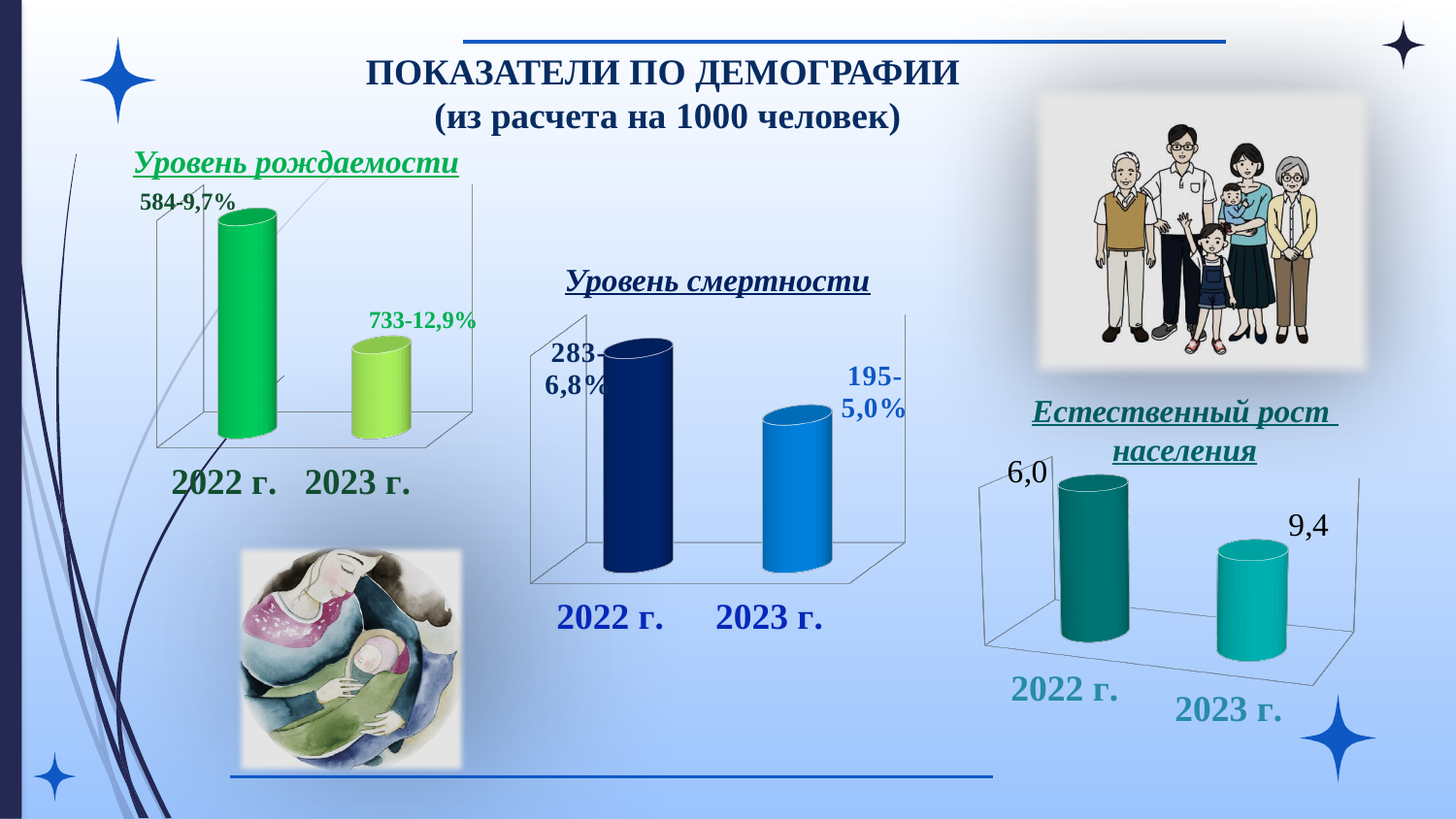
What type of chart is the 'Естественный рост населения' chart? Bar chart On the 'Уровень смертности' chart, what is the data label for 2022 г.? 283-6,8% What colour are the bars on the 'Уровень рождаемости' chart? Green On the 'Естественный рост населения' chart, what is the value for 2023 г.? 9,4 On the 'Естественный рост населения' chart, what is the value for 2022 г.? 6,0 What is the main title of the slide? ПОКАЗАТЕЛИ ПО ДЕМОГРАФИИ (из расчета на 1000 человек) On the 'Уровень смертности' chart, what is the data label for 2023 г.? 195-5,0% On the 'Уровень смертности' chart, by how much does the count for 2022 г. (283) exceed the count for 2023 г. (195)? 88 On the 'Уровень смертности' chart, which year has the taller bar? 2022 г. On the 'Уровень рождаемости' chart, what is the data label for 2023 г.? 733-12,9% On the 'Уровень рождаемости' chart, what is the data label for 2022 г.? 584-9,7% How many categories (years) are shown on the 'Уровень рождаемости' chart? 2